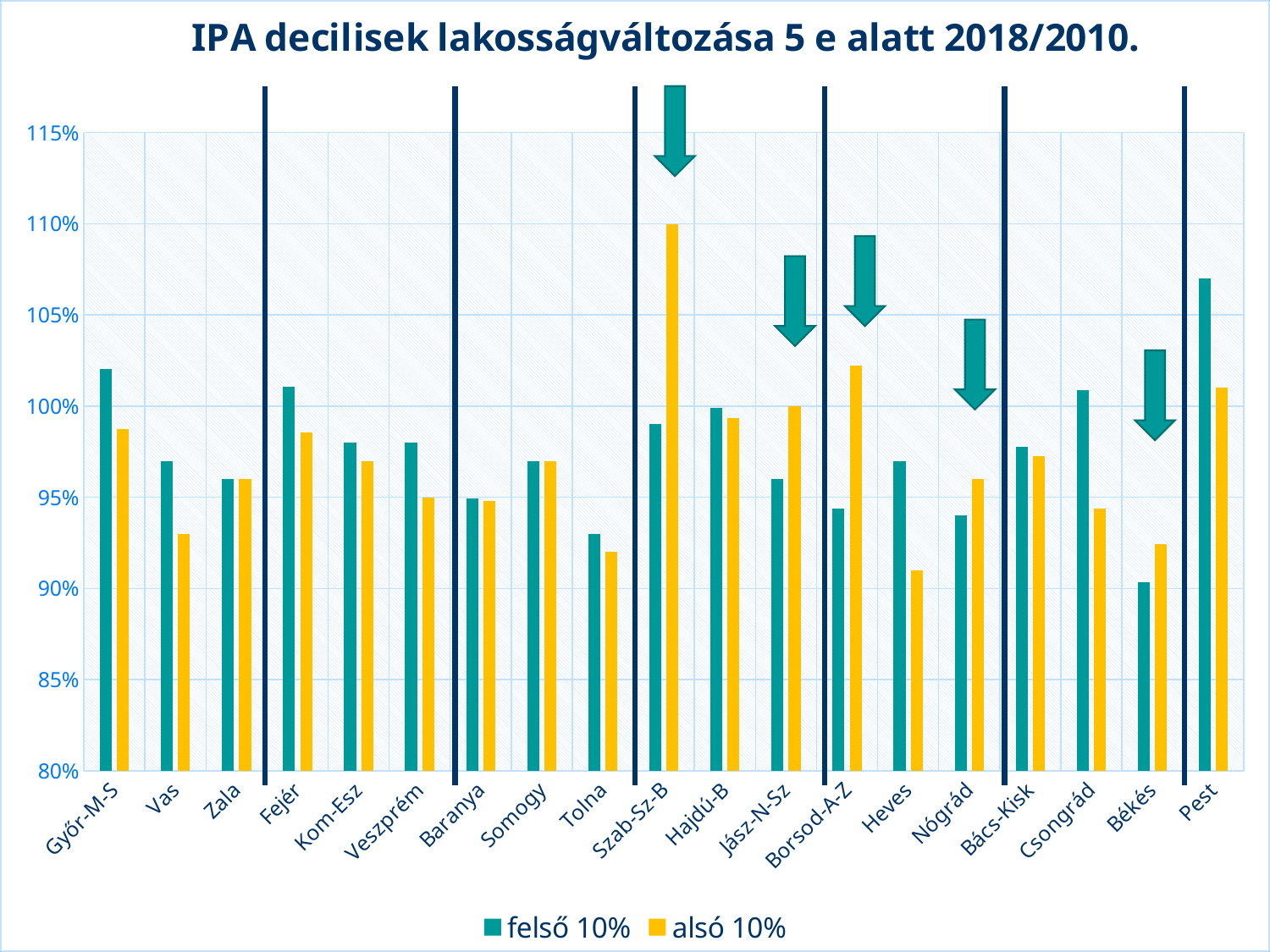
What is the title of the chart? IPA decilisek lakosságváltozása 5 e alatt 2018/2010. Which county has the lowest value for the felső 10% series? Békés Which county has the highest value for the alsó 10% series? Szab-Sz-B Is the alsó 10% value for Szab-Sz-B greater or less than 105%? greater What kind of chart is shown on the slide? bar chart Is the alsó 10% value for Heves greater or less than 95%? less Which county has the highest value for the felső 10% series? Pest Is the felső 10% value for Békés greater or less than 95%? less For Borsod-A-Z, which series has the larger value, felső 10% or alsó 10%? alsó 10% How many counties (categories) are shown on the x axis? 19 For Csongrád, which series has the larger value, felső 10% or alsó 10%? felső 10% How many series does the legend list? 2